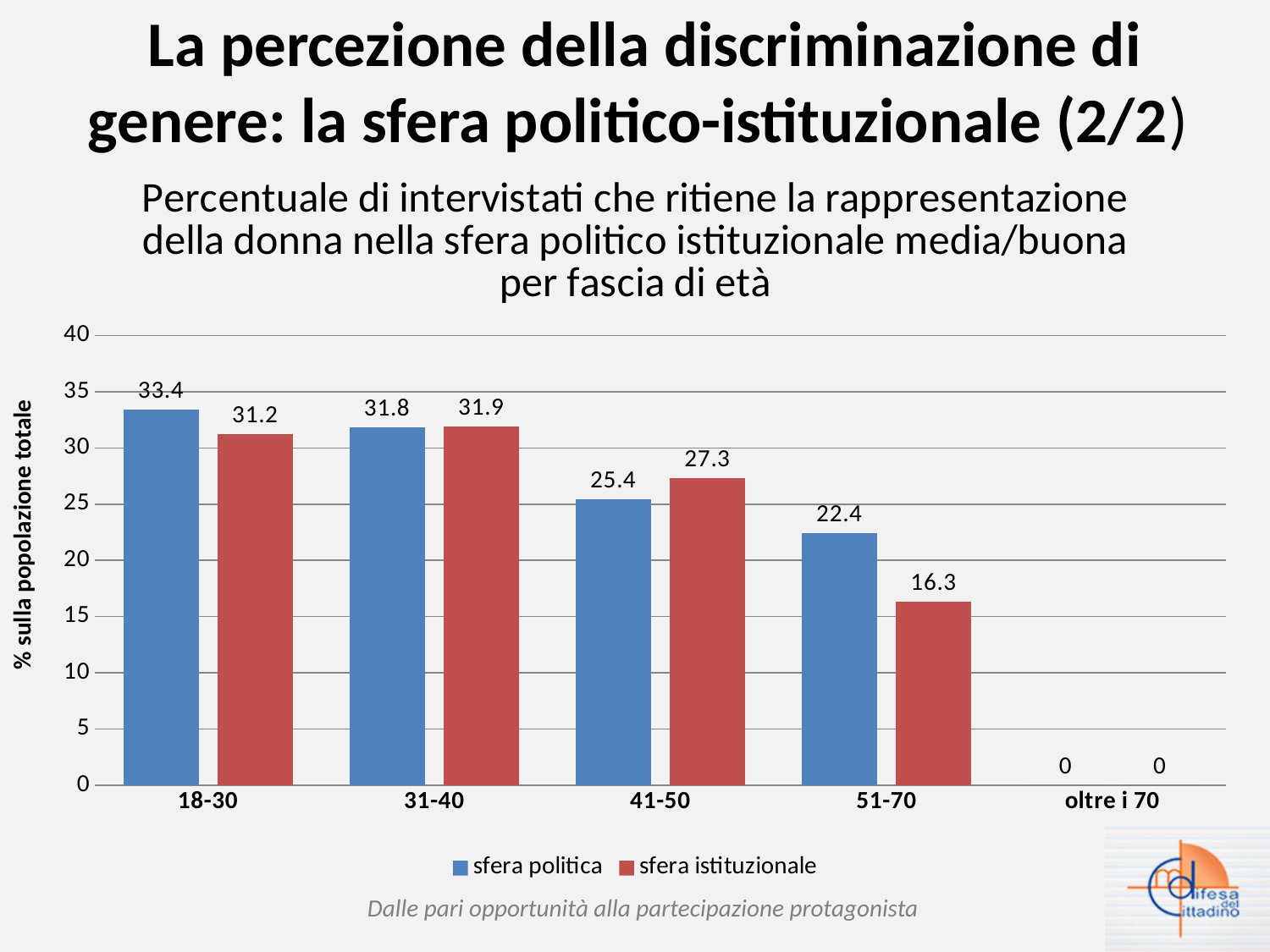
Do the values for 'sfera politica' rise or fall as the age groups increase along the x axis? fall Is the value for 'sfera politica' in the 51-70 age group greater or less than 25? less What is the value for 'sfera istituzionale' in the 41-50 age group? 27.3 In the 41-50 age group, which series has the larger value, 'sfera politica' or 'sfera istituzionale'? sfera istituzionale What is the value for 'sfera politica' in the 18-30 age group? 33.4 What is the value for 'sfera istituzionale' in the 51-70 age group? 16.3 Which age group has the highest value for 'sfera politica'? 18-30 How many age groups are shown on the x axis? 5 What is the difference between 'sfera politica' and 'sfera istituzionale' in the 51-70 age group? 6.1 Which age group has the lowest value for 'sfera istituzionale'? oltre i 70 How many series does the legend list? 2 What kind of chart is shown on the slide? bar chart